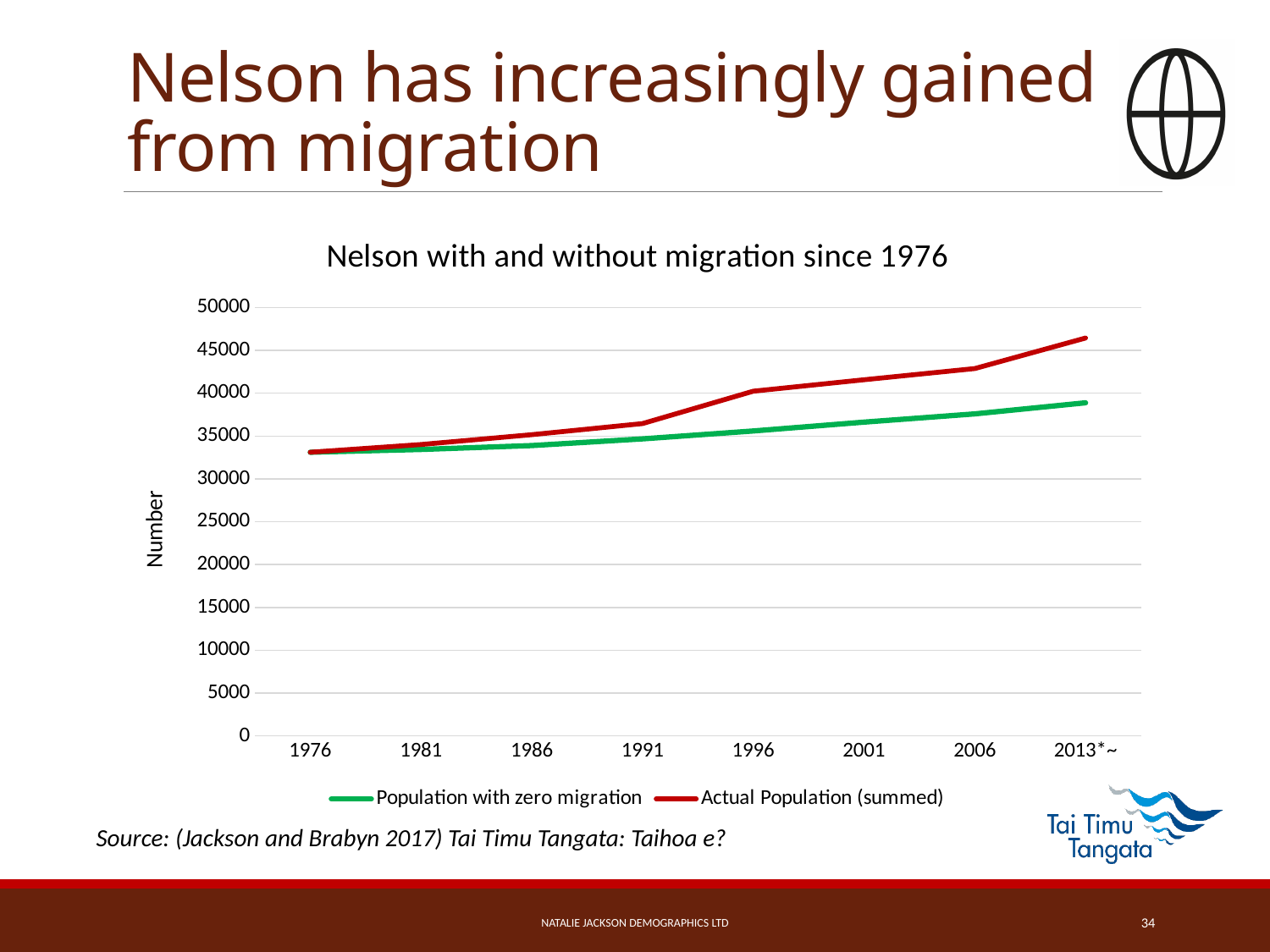
Is the value for Population with zero migration in 2013*~ greater or less than 40000? less Is the value for Actual Population (summed) in 2006 greater or less than 40000? greater How many series does the chart legend list? 2 What kind of chart is shown on the slide? line chart Is the value for Actual Population (summed) in 2013*~ greater or less than 45000? greater Does the Actual Population (summed) line rise or fall from 1976 to 2013*~? rise Does the Population with zero migration line rise or fall across the years shown? rise How many years are plotted along the x axis of the chart? 8 In 2013*~, which series has the larger value: Actual Population (summed) or Population with zero migration? Actual Population (summed) What is the title of the chart? Nelson with and without migration since 1976 What colour is the Actual Population (summed) line in the chart? red